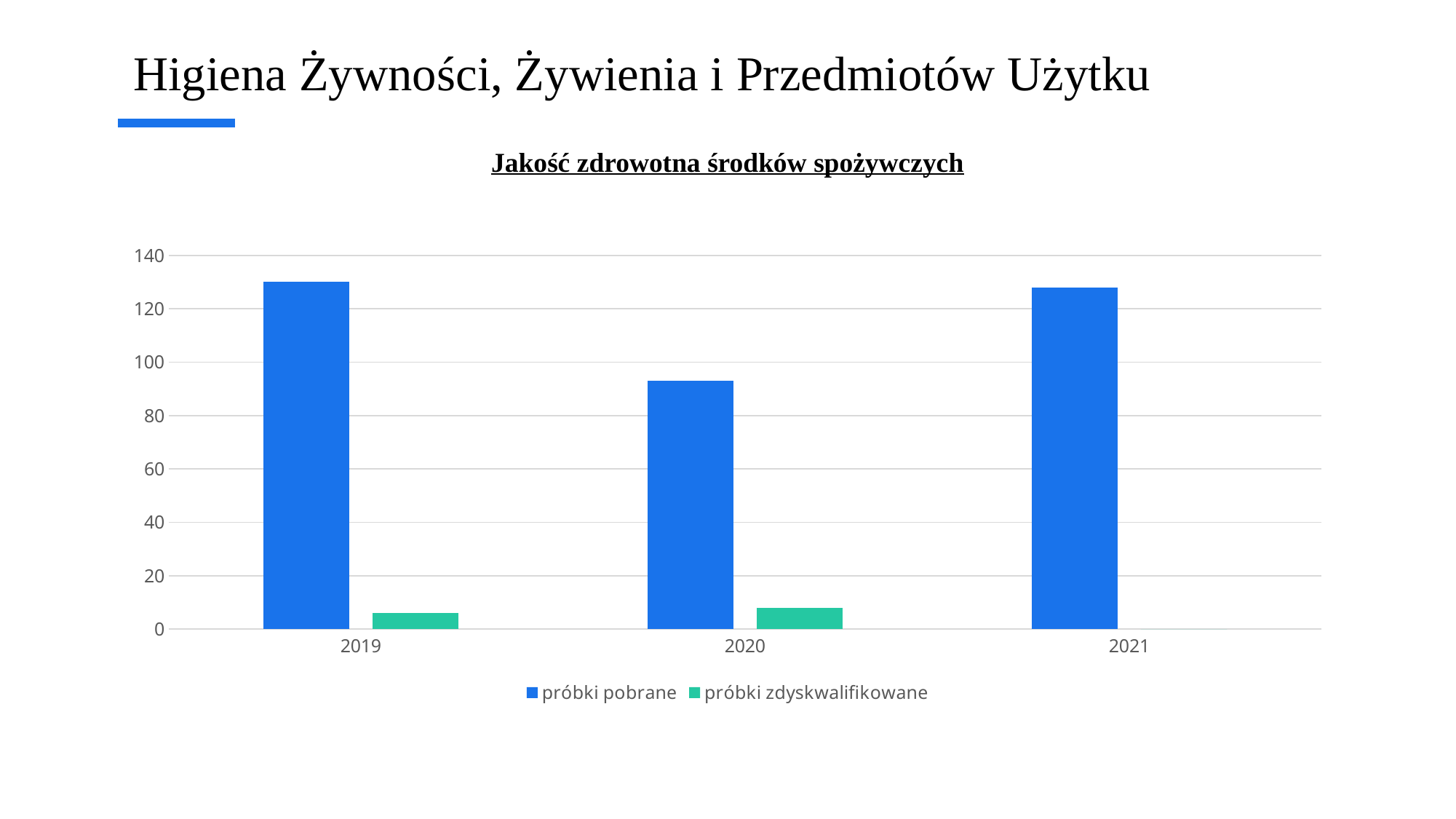
What is the title of the chart? Jakość zdrowotna środków spożywczych How many series does the legend list? 2 What kind of chart is shown on the slide? bar chart Is the value for próbki pobrane in 2019 greater or less than 120? greater Is the value for próbki pobrane in 2021 greater or less than 120? greater Is the value for próbki pobrane in 2020 greater or less than 100? less Which is larger for próbki pobrane: 2019 or 2020? 2019 How many years are shown on the x axis? 3 Which year has the lowest value for próbki pobrane? 2020 Which is larger in 2020: próbki pobrane or próbki zdyskwalifikowane? próbki pobrane